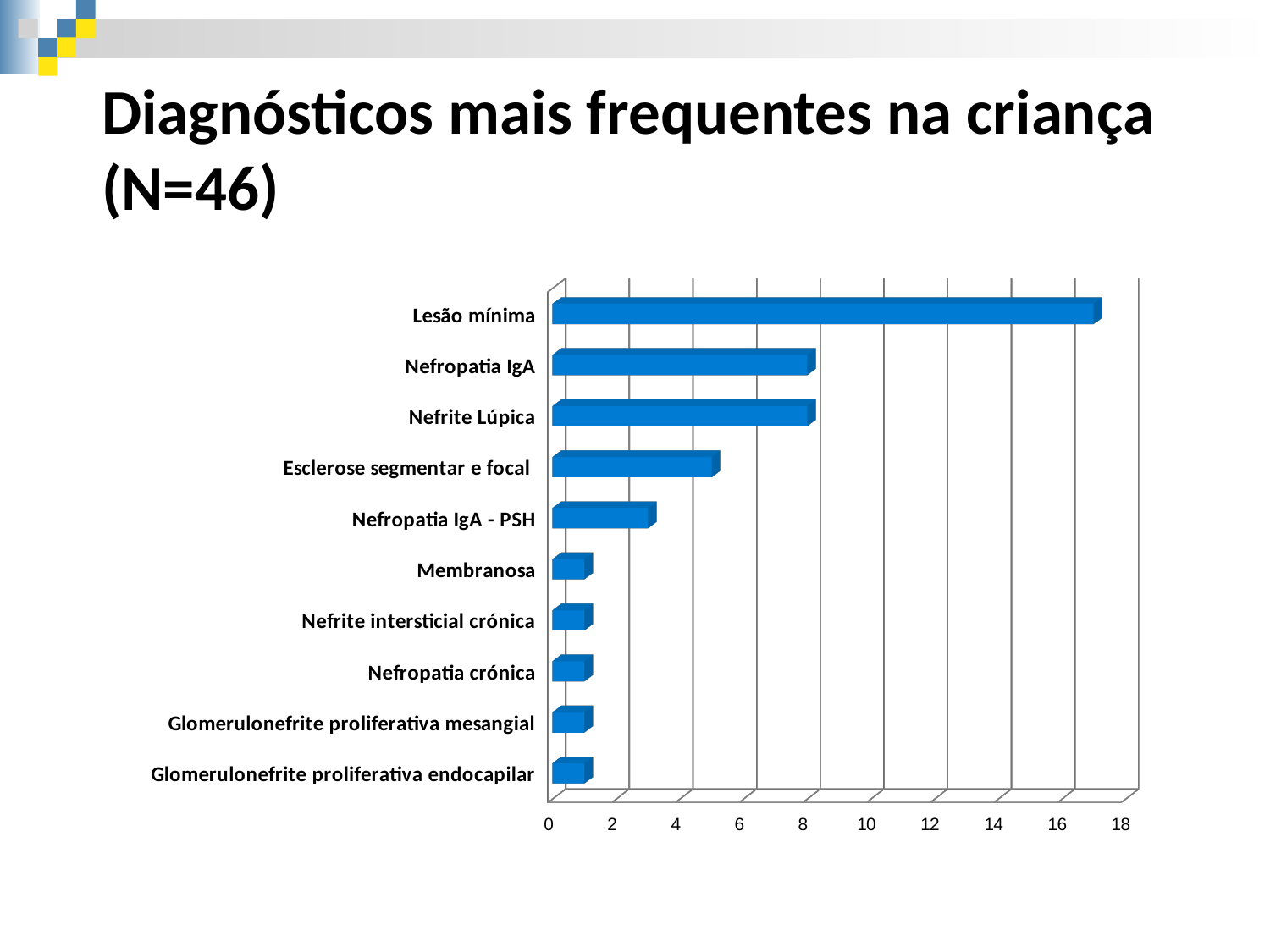
What is the title of the slide containing the chart? Diagnósticos mais frequentes na criança (N=46) Is the value for Membranosa greater or less than 2? less Which is larger, the value for Esclerose segmentar e focal or the value for Nefropatia IgA - PSH? Esclerose segmentar e focal Is the value for Esclerose segmentar e focal greater or less than 4? greater Is the value for Nefropatia IgA greater or less than 6? greater Which is larger, the value for Nefrite Lúpica or the value for Membranosa? Nefrite Lúpica Which diagnosis has the highest value in the chart? Lesão mínima Which is larger, the value for Lesão mínima or the value for Nefropatia IgA? Lesão mínima How many diagnosis categories are plotted in the chart? 10 What kind of chart is shown on the slide? bar chart